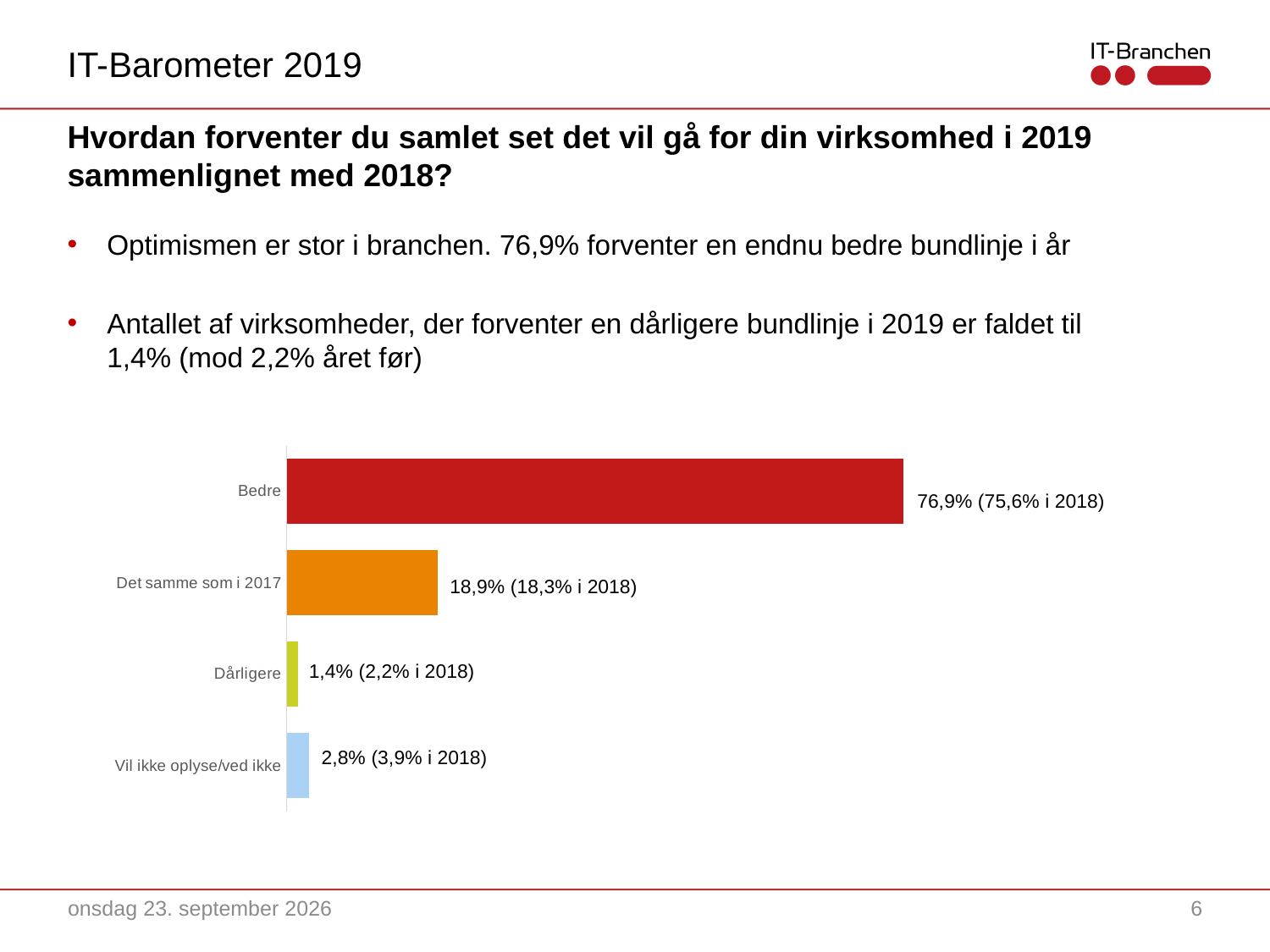
According to the data label, what was the 2018 value for "Dårligere"? 2,2% What is the value shown for "Bedre" in the chart? 76,9% What is the value shown for "Dårligere"? 1,4% Which is larger, the value for "Dårligere" or the value for "Vil ikke oplyse/ved ikke"? Vil ikke oplyse/ved ikke What is the difference between the values for "Bedre" and "Det samme som i 2017"? 58,0% How many categories are shown in the chart? 4 What is the value shown for "Det samme som i 2017"? 18,9% What is the value shown for "Vil ikke oplyse/ved ikke"? 2,8% Which category has the highest value in the chart? Bedre What kind of chart is shown on the slide? Bar chart Which category has the lowest value in the chart? Dårligere According to the data label, what was the 2018 value for "Bedre"? 75,6%